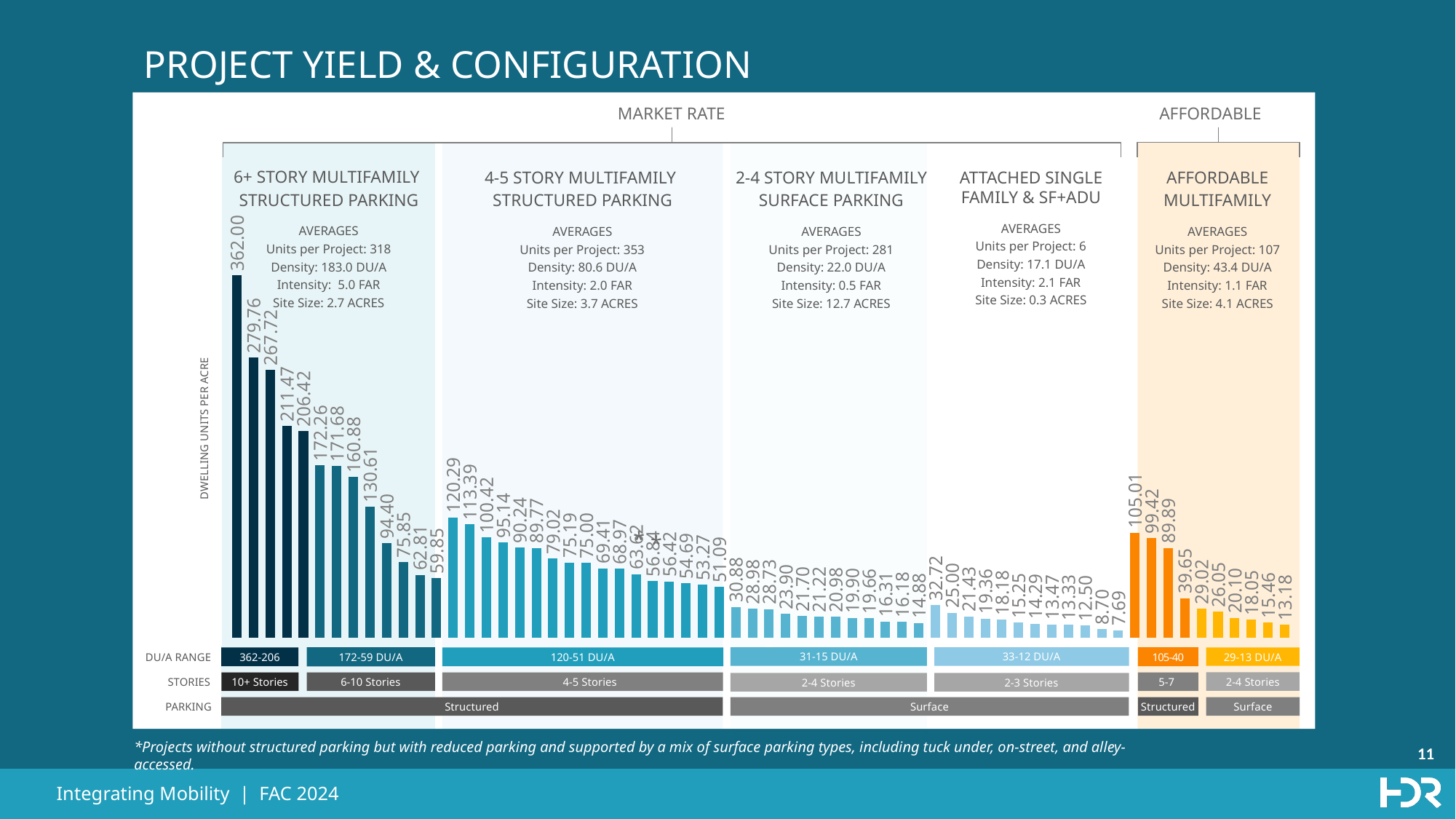
What is the difference between the two tallest bars in the 6+ Story Multifamily Structured Parking group (362.00 and 279.76)? 82.24 Which is larger: the tallest bar in the 4-5 Story Multifamily Structured Parking group (120.29) or the 130.61 bar in the 6+ Story group? 130.61 What DU/A range is shown for the 4-5 Story Multifamily Structured Parking group? 120-51 DU/A What is the label on the vertical axis of the chart? Dwelling Units Per Acre What is the average density listed for the 2-4 Story Multifamily Surface Parking group? 22.0 DU/A What is the highest value plotted in the Affordable Multifamily group? 105.01 Within each group, do the bar values rise or fall from left to right? fall How many bars are plotted in the 6+ Story Multifamily Structured Parking group? 13 What is the highest dwelling units per acre value plotted on the chart? 362.00 What kind of chart is shown on the slide? bar chart How many bars are plotted in the Affordable Multifamily group? 10 What is the lowest dwelling units per acre value plotted on the chart? 7.69